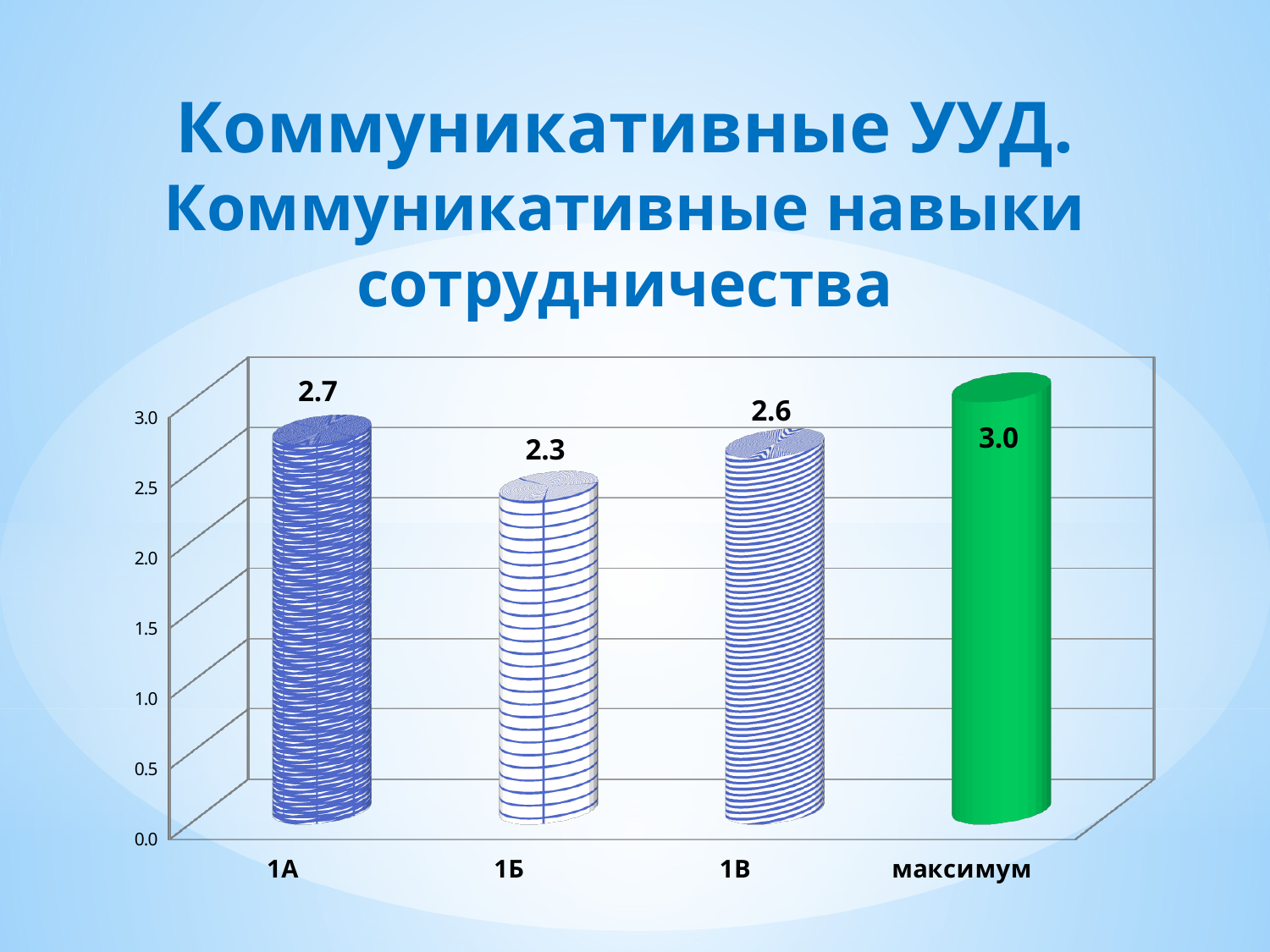
What is the difference between the values for 1А and 1Б? 0.4 What colour is the bar for максимум? green Which category has the lowest value? 1Б Which is larger, the value for 1А or the value for 1В? 1А What is the value for 1В? 2.6 What is the difference between the value for максимум and the value for 1В? 0.4 Which category has the highest value? максимум What is the value for максимум? 3.0 What is the value for 1А? 2.7 What kind of chart is shown on the slide? bar chart What is the value for 1Б? 2.3 How many categories are shown on the chart? 4